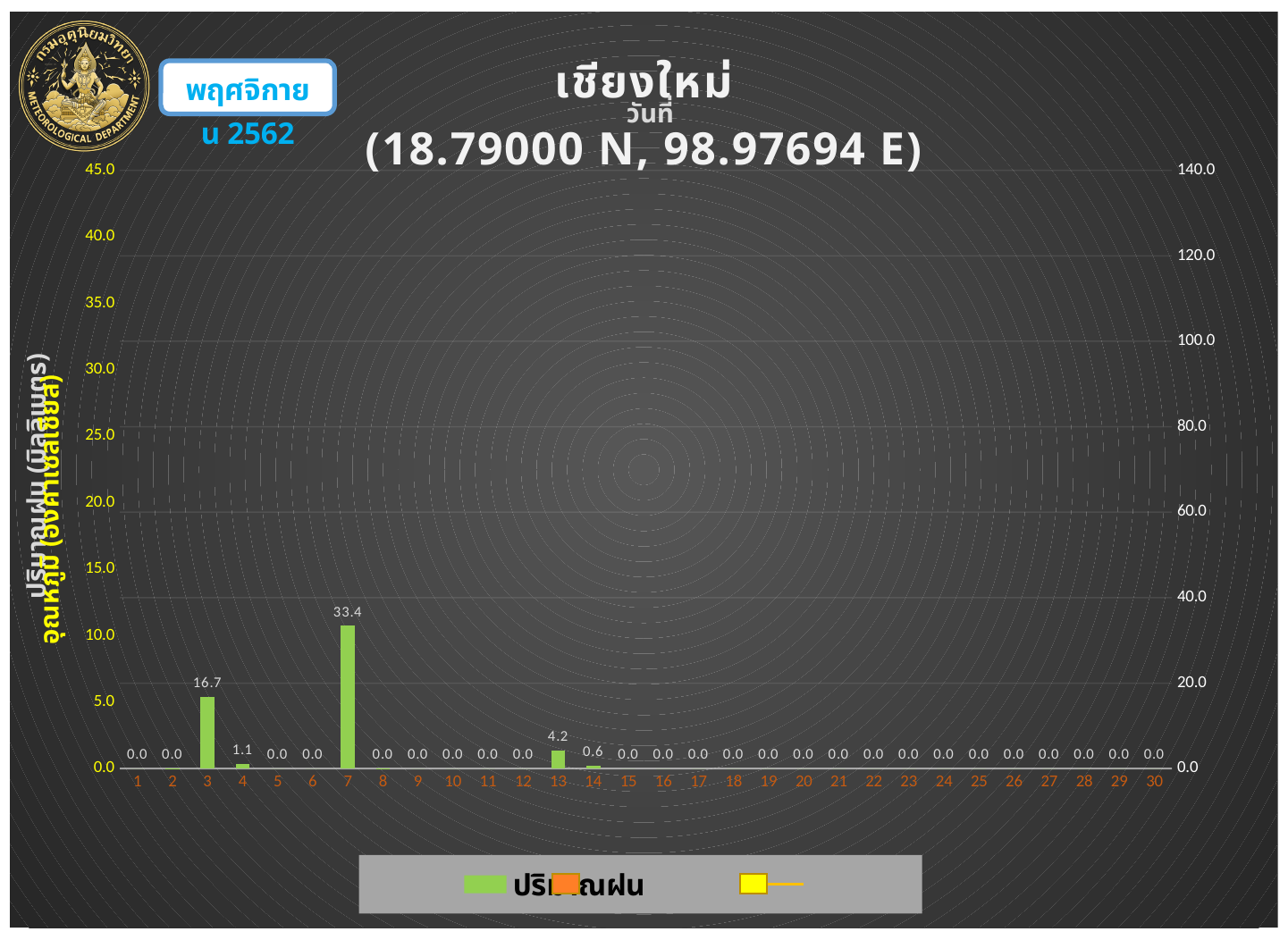
What is the rainfall value shown for day 13? 4.2 What is the rainfall value shown for day 4? 1.1 What is the highest value shown on the right-hand axis? 140.0 What is the rainfall value shown for day 7? 33.4 What kind of chart is used to show the rainfall values? bar chart What is the difference between the rainfall values for day 13 and day 14? 3.6 What is the difference between the rainfall values for day 7 and day 3? 16.7 Which is larger, the rainfall value for day 13 or for day 4? day 13 What is the rainfall value shown for day 3? 16.7 How many days are shown on the x axis? 30 What is the rainfall value shown for day 14? 0.6 Which day has the highest rainfall value? 7